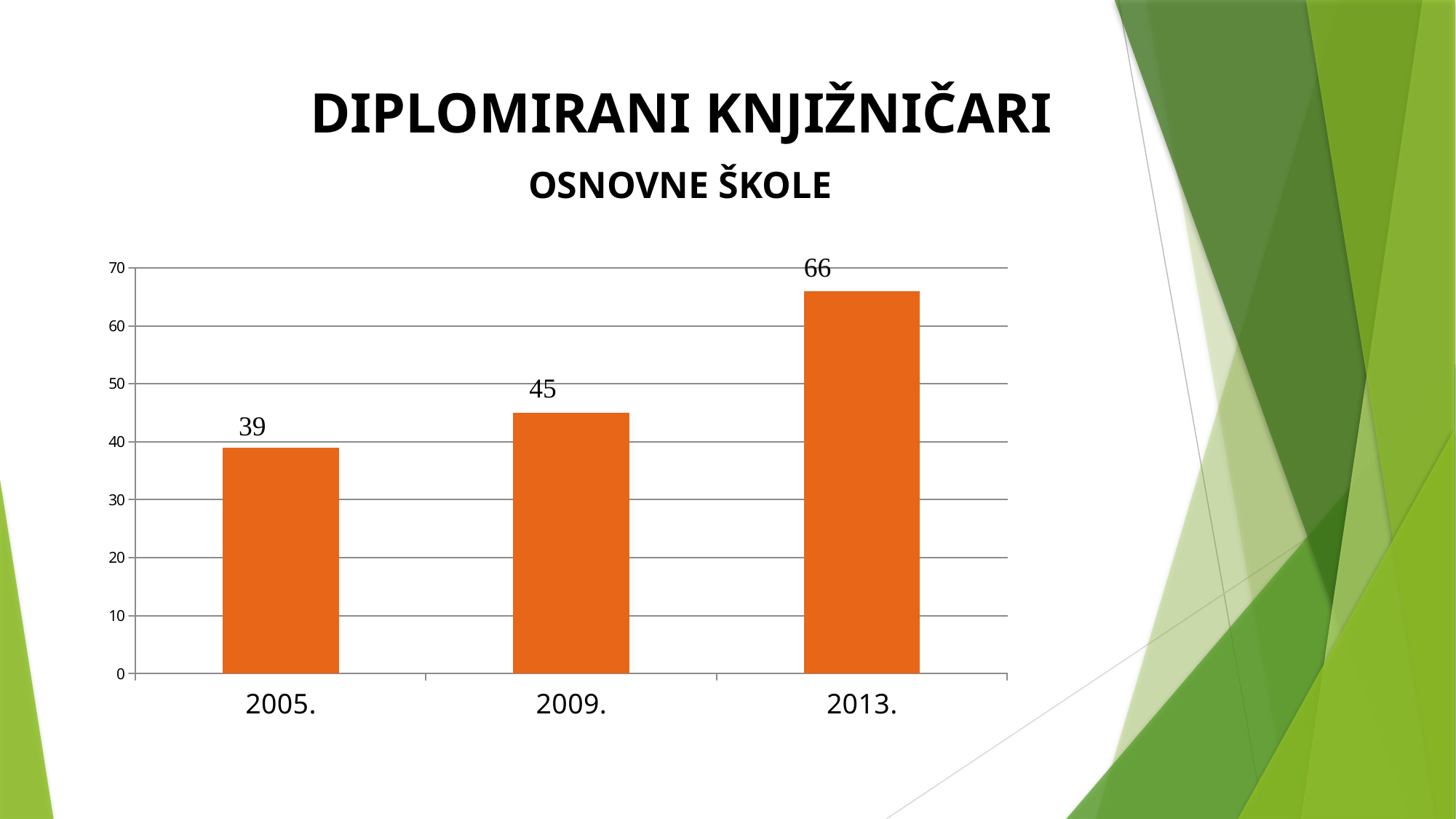
Is the value for 2013. greater or less than 60? greater What is the difference between the values for 2009. and 2005.? 6 Which is larger, the value for 2009. or the value for 2013.? 2013. What is the difference between the values for 2013. and 2005.? 27 Do the values rise or fall from 2005. to 2013.? rise What is the value for 2005.? 39 What kind of chart is shown on the slide? bar chart Which year has the lowest value? 2005. Which year has the highest value? 2013. What is the value for 2013.? 66 How many years are shown on the x axis? 3 What is the value for 2009.? 45